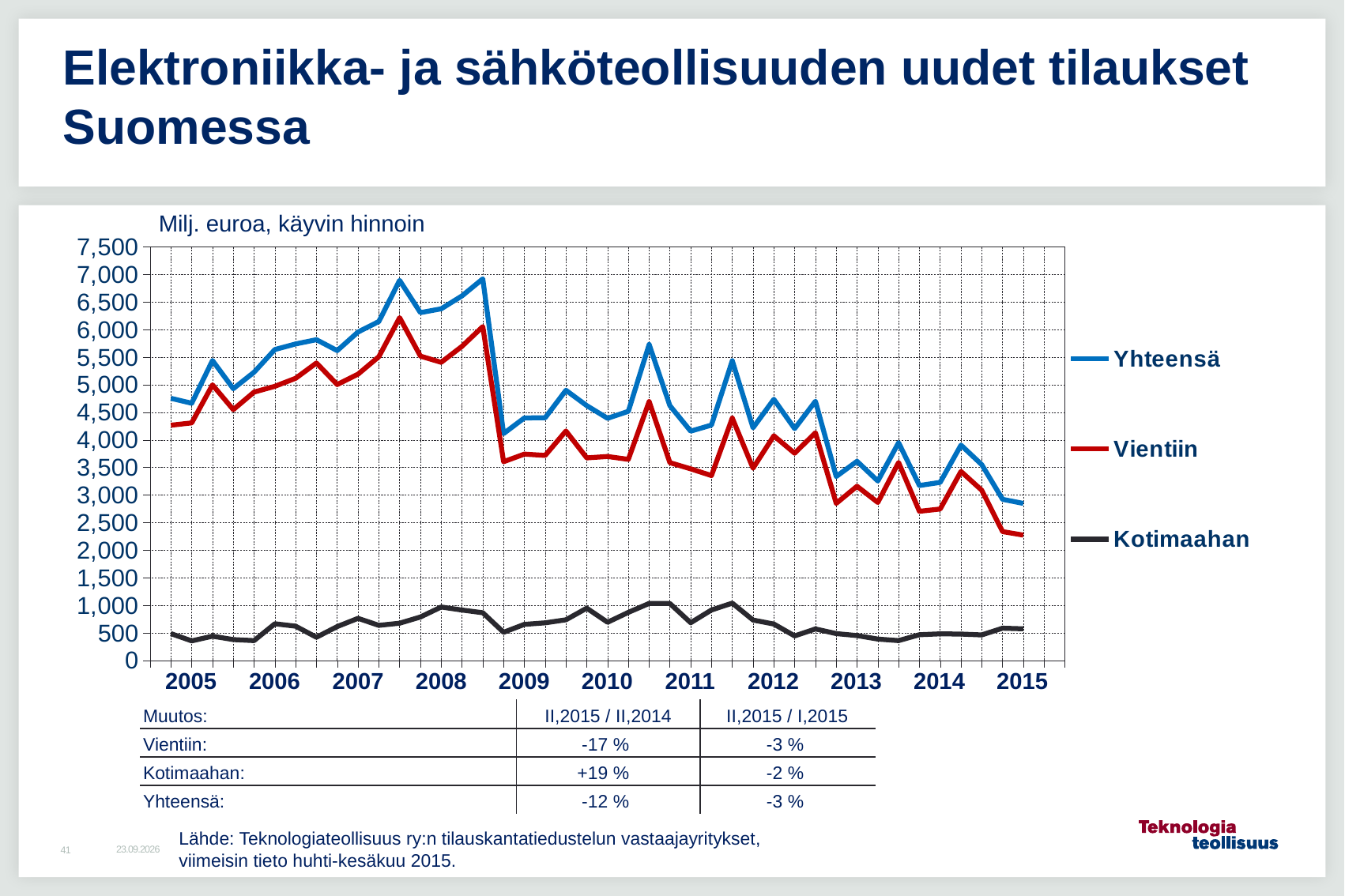
Which series has the lowest values throughout the chart? Kotimaahan Is the value for Kotimaahan in 2015 greater or less than 1,000? less What unit is stated above the chart? Milj. euroa, käyvin hinnoin Is the first value for Yhteensä in 2005 greater or less than 4,000? greater Which is larger in 2010, Yhteensä or Kotimaahan? Yhteensä Which series is drawn in red? Vientiin Does the Yhteensä series generally rise or fall from 2012 to 2015? fall Is the last value for Vientiin in 2015 greater or less than 2,500? less How many series does the legend list? 3 Which series has the highest values throughout the chart? Yhteensä What kind of chart is shown on the slide? line chart